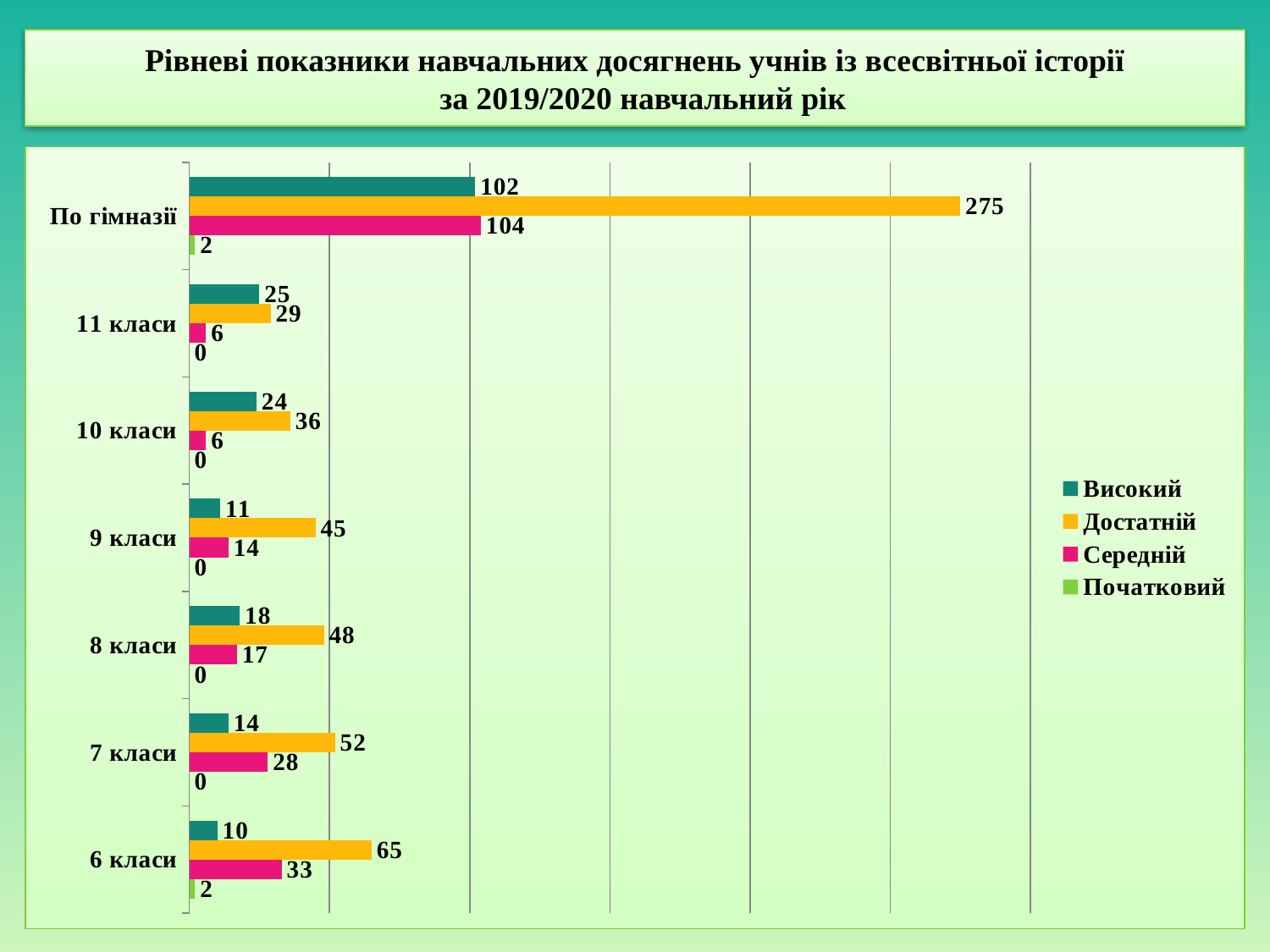
What is the value of Достатній for По гімназії? 275 What is the difference between the Достатній and Високий values for По гімназії? 173 What is the total of the four values for 9 класи? 70 How many categories are shown on the vertical axis? 7 Which legend entry is shown in green? Початковий How many series does the legend list? 4 Which class group has the lowest Високий value? 6 класи What is the value of Середній for 6 класи? 33 Which category has the highest Достатній value among the individual class groups (excluding По гімназії)? 6 класи What is the value of Високий for 11 класи? 25 Which is larger for 7 класи: Достатній or Середній? Достатній What kind of chart is shown on the slide? Bar chart